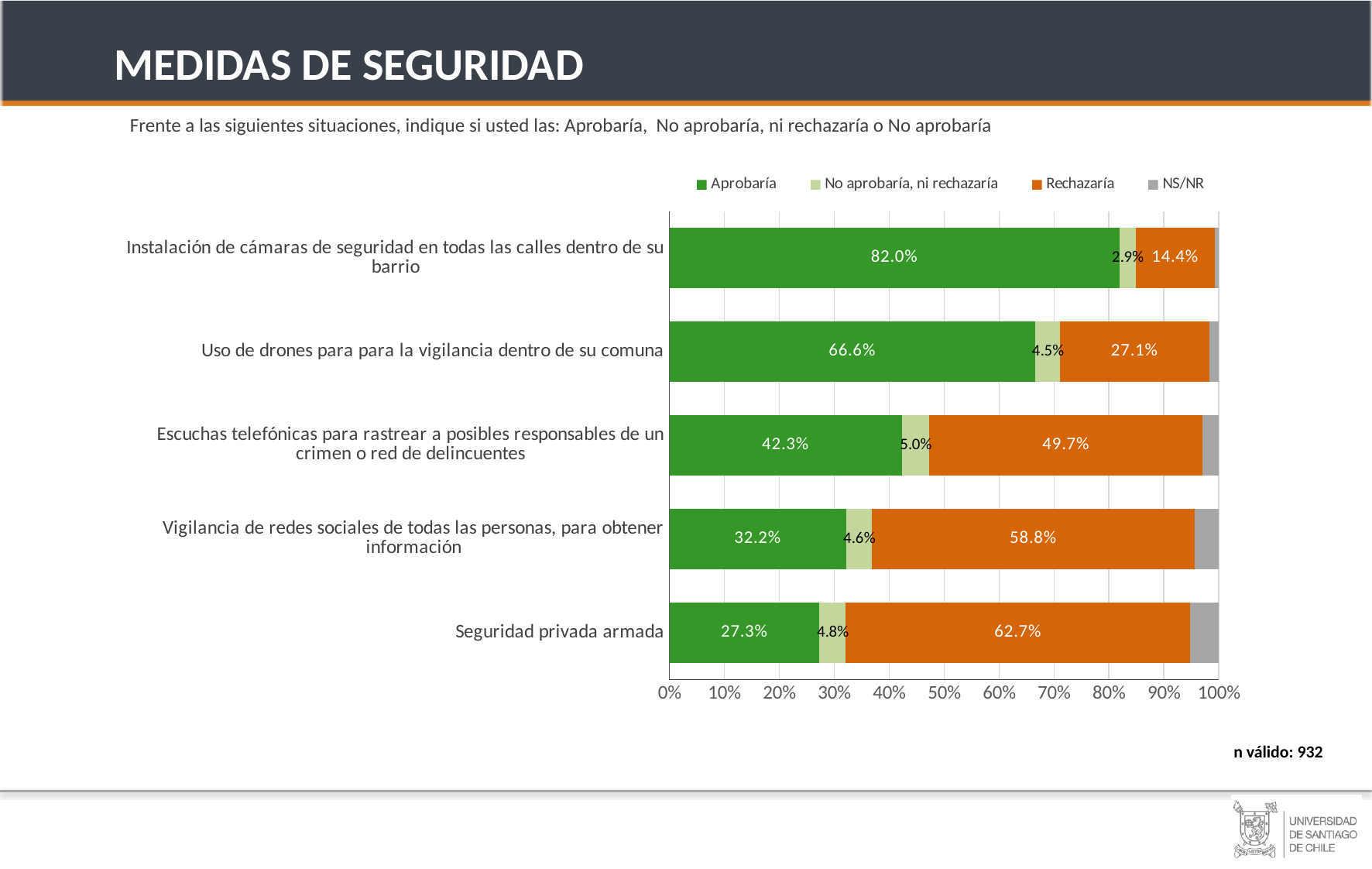
Which measure has the lowest Aprobaría percentage? Seguridad privada armada Which measure has the highest Aprobaría percentage? Instalación de cámaras de seguridad en todas las calles dentro de su barrio What is the Rechazaría value for 'Seguridad privada armada'? 62.7% What kind of chart is shown on the slide? Stacked bar chart What percentage of respondents would approve (Aprobaría) the installation of security cameras in all streets within their neighborhood? 82.0% How many series does the legend list? 4 What is the valid sample size (n válido) shown on the slide? 932 What is the 'No aprobaría, ni rechazaría' value for 'Escuchas telefónicas para rastrear a posibles responsables de un crimen o red de delincuentes'? 5.0% Which is larger for 'Escuchas telefónicas': the Aprobaría value or the Rechazaría value? Rechazaría (49.7%) What is the Rechazaría value for 'Uso de drones para para la vigilancia dentro de su comuna'? 27.1% What is the difference between the Rechazaría values for 'Seguridad privada armada' and 'Vigilancia de redes sociales de todas las personas, para obtener información'? 3.9% How many security measures (categories) are shown in the chart? 5